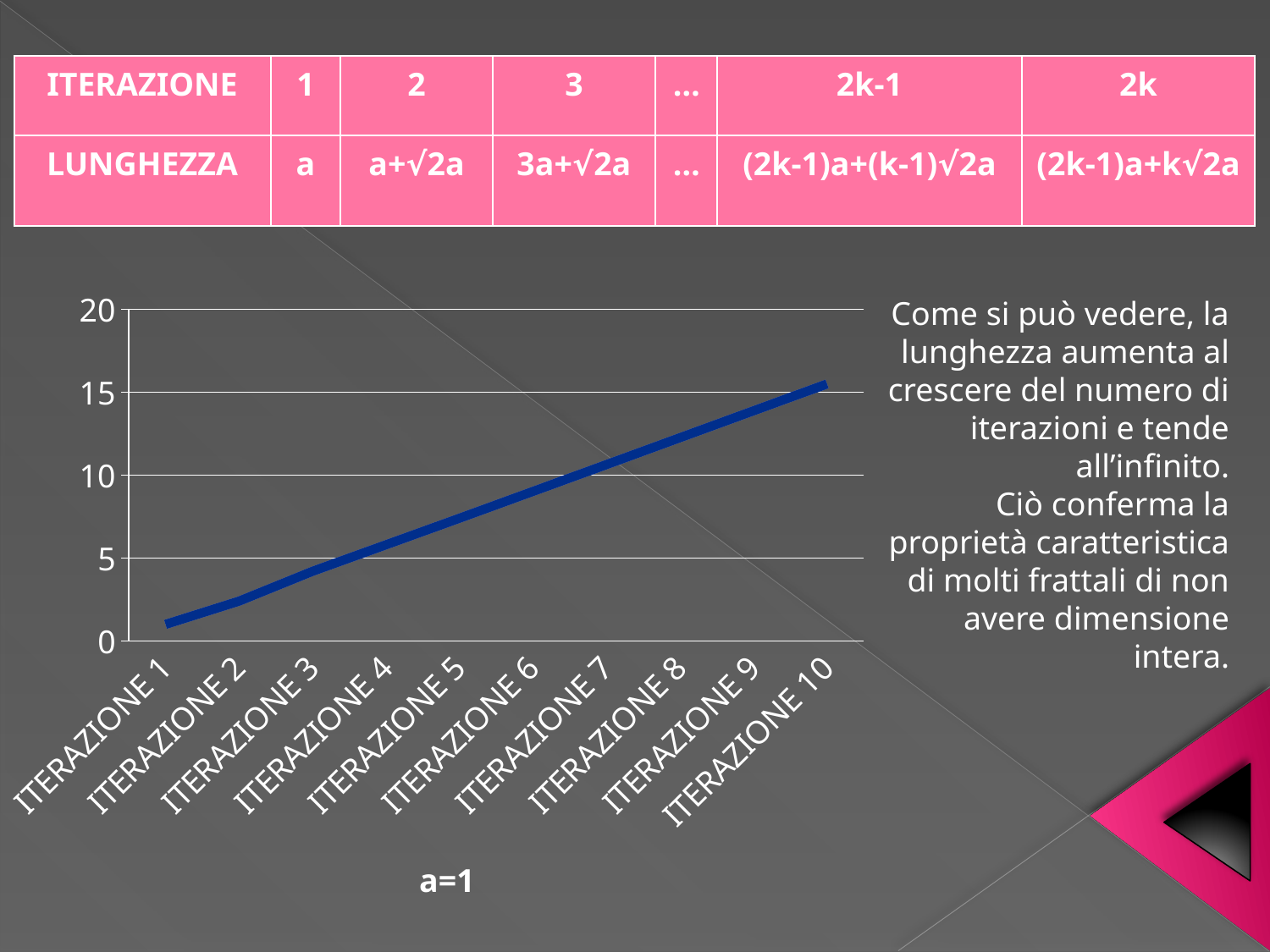
Is the value for ITERAZIONE 5 greater or less than 5? greater Is the value for ITERAZIONE 3 greater or less than 5? less Is the value for ITERAZIONE 1 greater or less than 5? less Which iteration has the lowest value on the chart? ITERAZIONE 1 Which iteration has the highest value on the chart? ITERAZIONE 10 What kind of chart is shown on the slide? line chart How many iterations are plotted along the x axis of the chart? 10 Does the plotted line rise or fall from ITERAZIONE 1 to ITERAZIONE 10? rise Which is larger, the value for ITERAZIONE 8 or the value for ITERAZIONE 2? ITERAZIONE 8